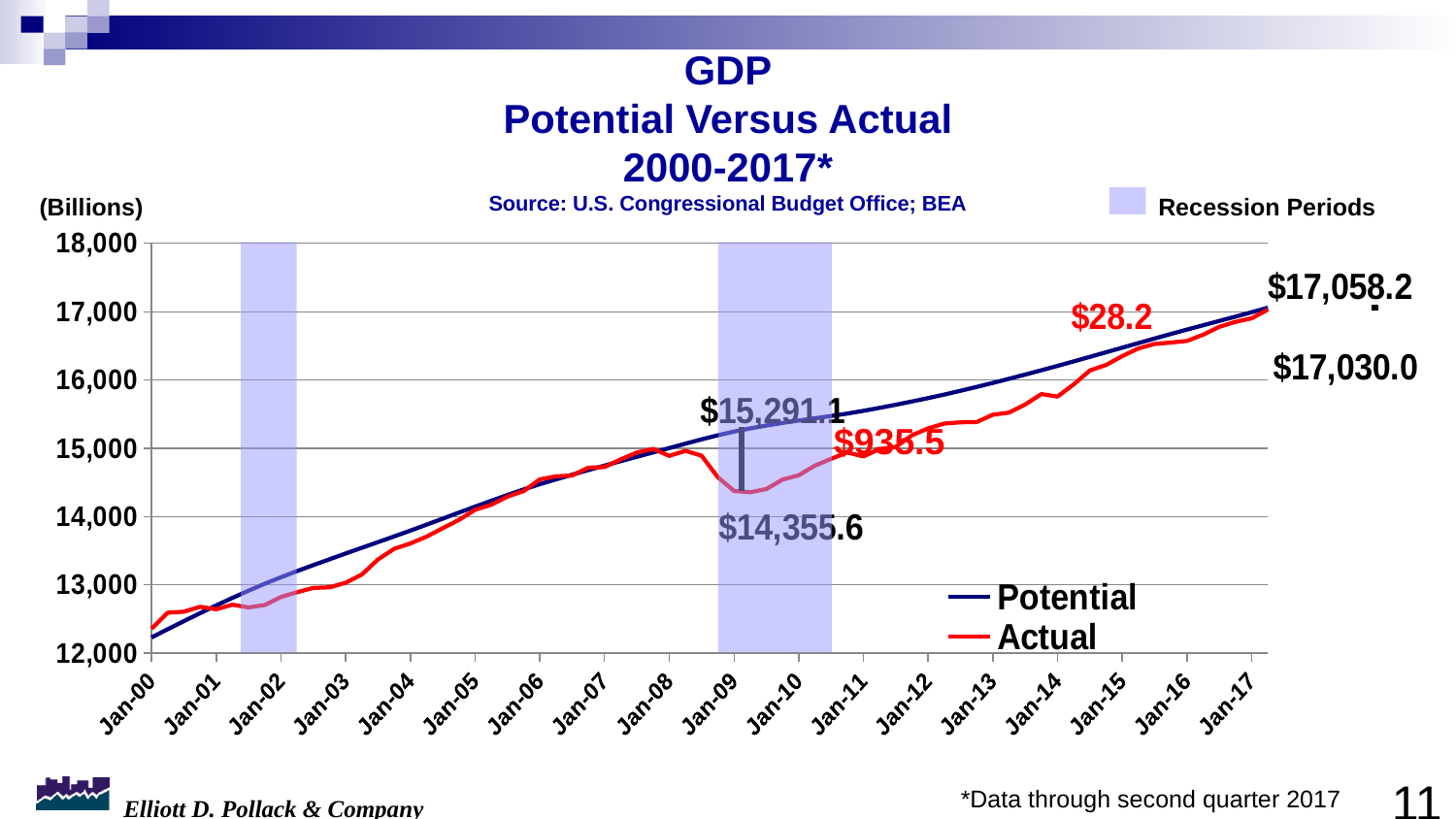
What gap between Potential and Actual GDP is labeled around Jan-09 to Jan-10? $935.5 What type of chart is shown on the slide? line chart How many series does the legend list? 2 What is the labeled value of the Potential line at the end of the series (2017)? $17,058.2 What value is labeled for the Potential line at the point around Jan-09? $15,291.1 What is the labeled value of the Actual line at the end of the series (2017)? $17,030.0 Is the Actual value at Jan-00 greater or less than 13,000? less What are the two series named in the legend? Potential and Actual What value is labeled for the Actual line at the point around Jan-09? $14,355.6 What is the difference between the final Potential value ($17,058.2) and the final Actual value ($17,030.0)? $28.2 Around Jan-09, which is larger, the Potential value or the Actual value? Potential What unit is indicated for the y-axis values? Billions